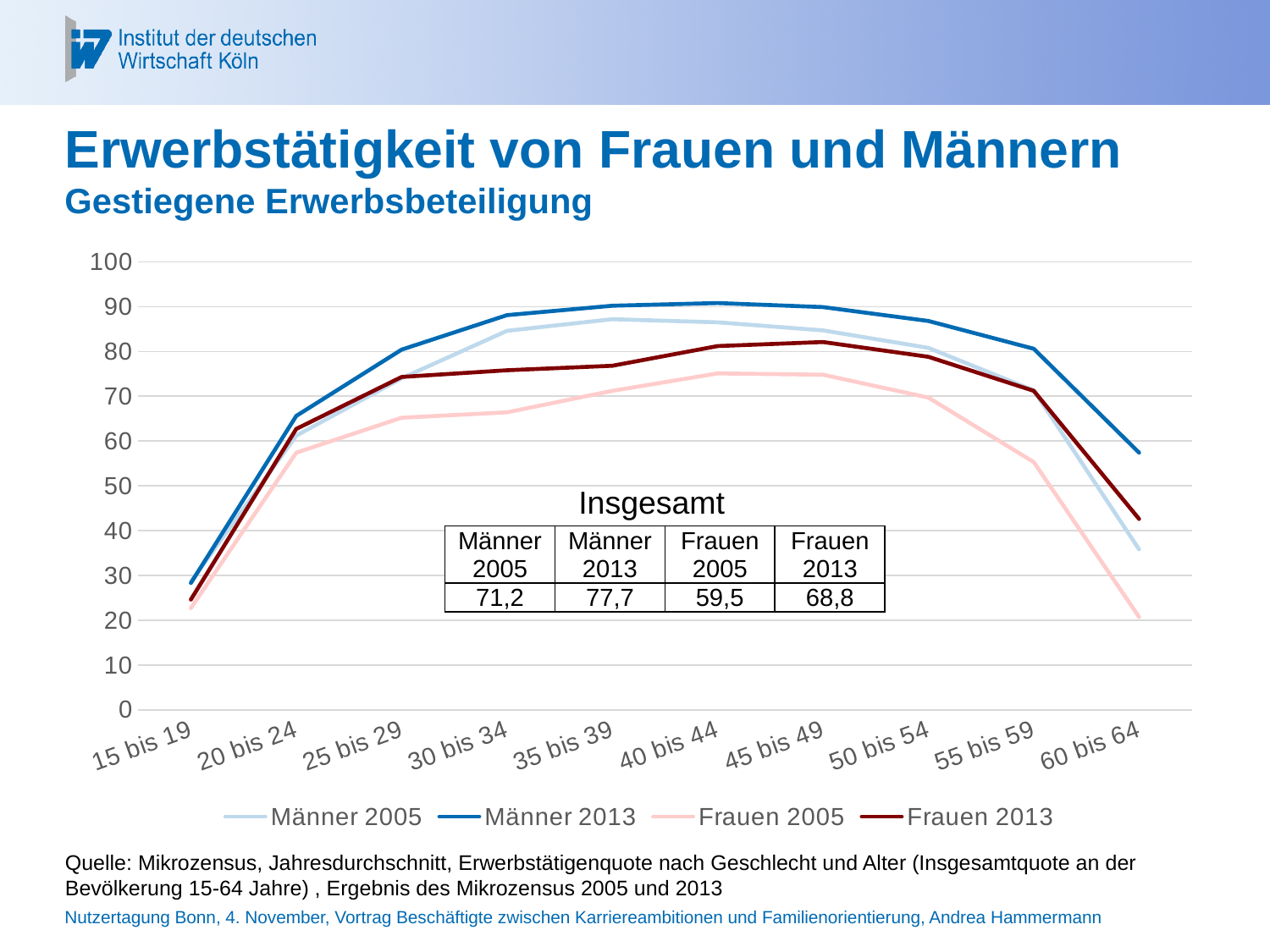
How many age groups are shown on the x axis? 10 Using the Insgesamt table, what is the difference between Frauen 2013 and Frauen 2005? 9,3 Which age group has the lowest value for Männer 2013? 15 bis 19 Is the value for Männer 2013 in the 15 bis 19 age group greater or less than 30? less Is the value for Frauen 2013 in the 45 bis 49 age group greater or less than 80? greater In the 55 bis 59 age group, which is larger: Frauen 2013 or Frauen 2005? Frauen 2013 How many series does the legend list? 4 According to the Insgesamt table, what is the overall value for Frauen 2005? 59,5 Do the values for Männer 2013 rise or fall from 45 bis 49 to 60 bis 64? fall Is the value for Männer 2005 in the 60 bis 64 age group greater or less than 40? less What kind of chart is shown on the slide? line chart According to the Insgesamt table, what is the overall value for Männer 2013? 77,7